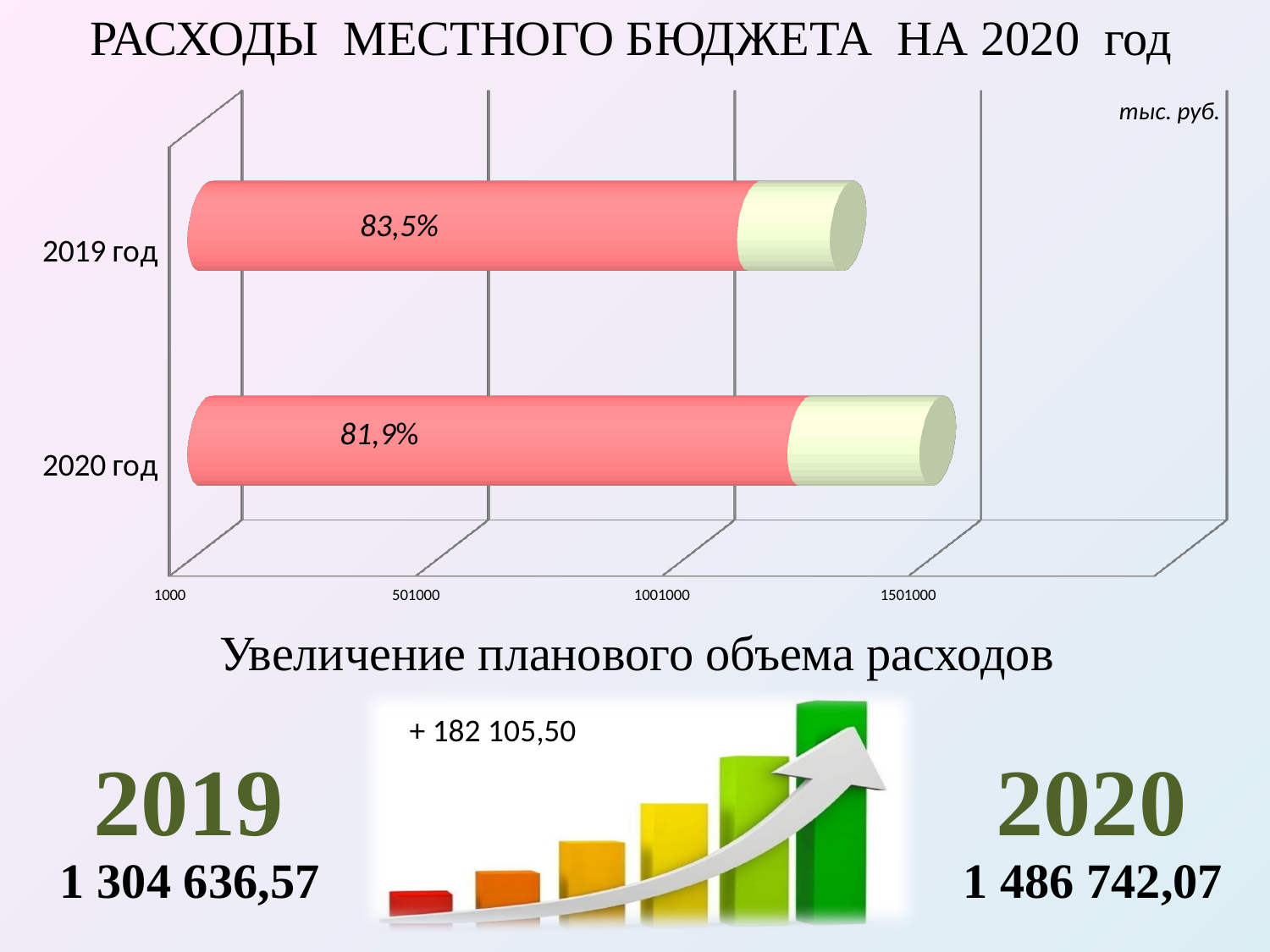
What percentage label is shown on the pink segment of the bar for 2019 год? 83,5% Which bar is longer overall, 2019 год or 2020 год? 2020 год What kind of chart is shown on the slide? bar chart What percentage label is shown on the pink segment of the bar for 2020 год? 81,9% How many categories (years) are plotted in the chart? 2 What is the difference between the 2020 expenditure (1 486 742,07) and the 2019 expenditure (1 304 636,57) shown on the slide? 182 105,50 Is the total value of the bar for 2019 год greater or less than 1501000? less Do the total expenditures rise or fall from 2019 to 2020? rise Is the total value of the bar for 2020 год greater or less than 1001000? greater What unit of measurement is indicated in the top right corner of the chart? тыс. руб. Which year has the higher percentage label on its pink segment, 2019 год or 2020 год? 2019 год What is the title of the chart? РАСХОДЫ МЕСТНОГО БЮДЖЕТА НА 2020 год